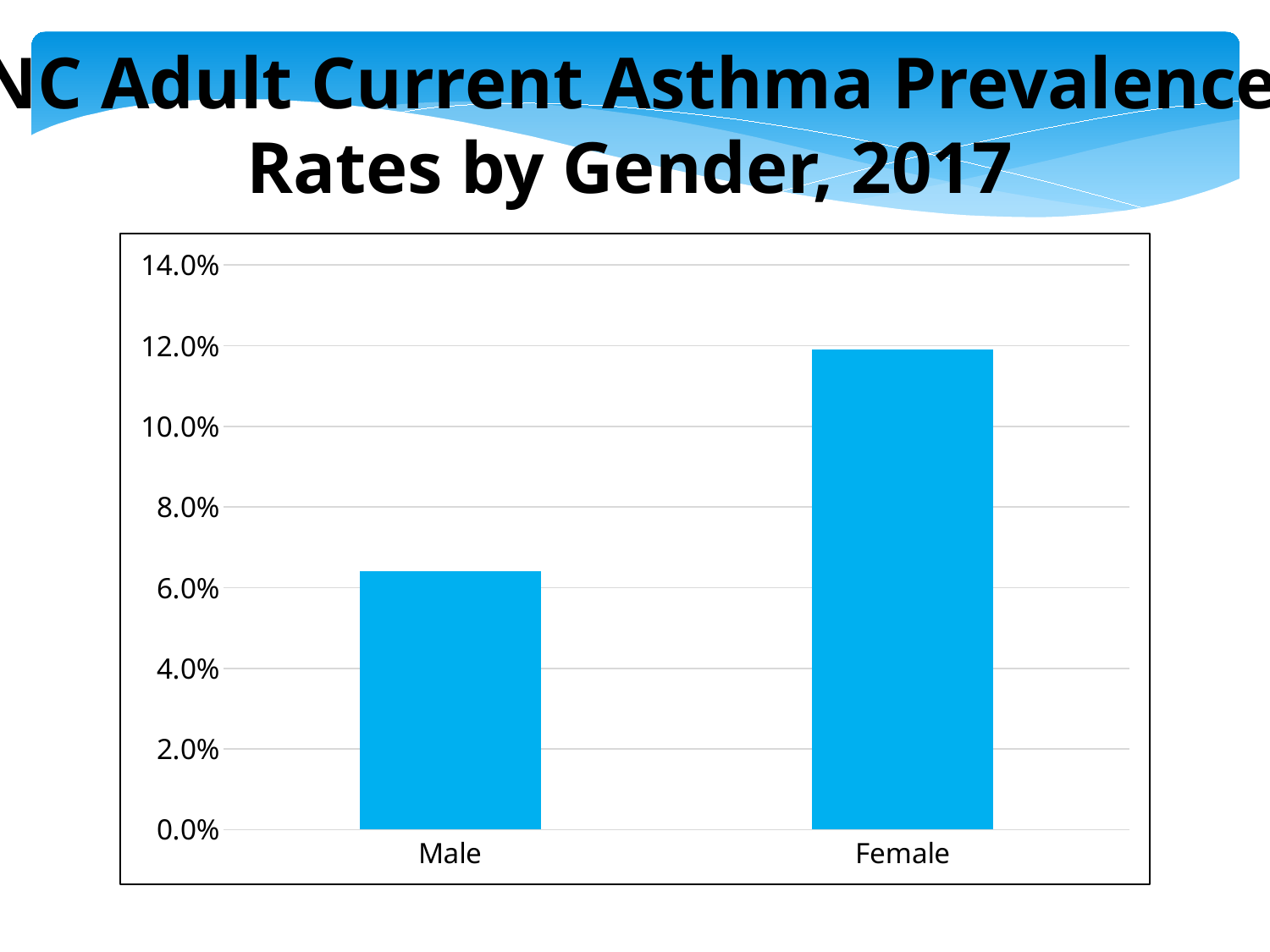
Which gender has the lower asthma prevalence rate? Male How many categories are shown on the x axis? 2 Is the value for Male or Female larger? Female Is the value for Female greater or less than 10.0%? greater Which gender has the higher asthma prevalence rate? Female Is the value for Male greater or less than 6.0%? greater What kind of chart is shown on the slide? bar chart What year does the chart title refer to? 2017 What is the highest value shown on the y axis? 14.0% Is the value for Male greater or less than 8.0%? less